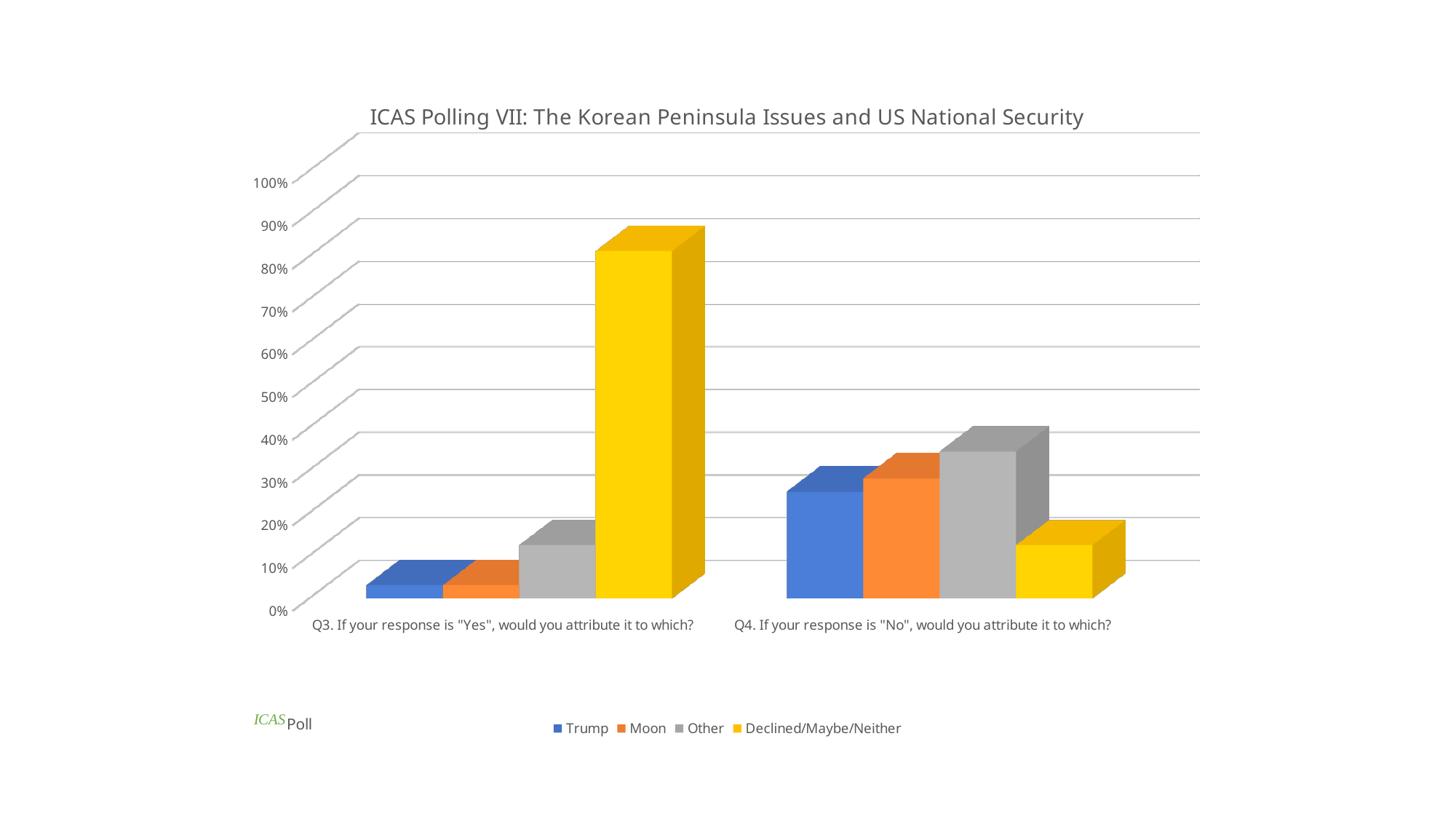
Is the Declined/Maybe/Neither value for Q4 greater or less than 20%? less How many question categories are shown on the x axis? 2 What kind of chart is shown on the slide? bar chart Is the Other value for Q4 greater or less than 30%? greater Is the Other value for Q3 greater or less than 20%? less Which series has the highest value for Q3 ("Yes" responses)? Declined/Maybe/Neither How many series does the legend list? 4 Which is larger: the Declined/Maybe/Neither value for Q3 or for Q4? Q3 Which series has the lowest value for Q4 ("No" responses)? Declined/Maybe/Neither Which series has the highest value for Q4 ("No" responses)? Other What is the title of the chart? ICAS Polling VII: The Korean Peninsula Issues and US National Security